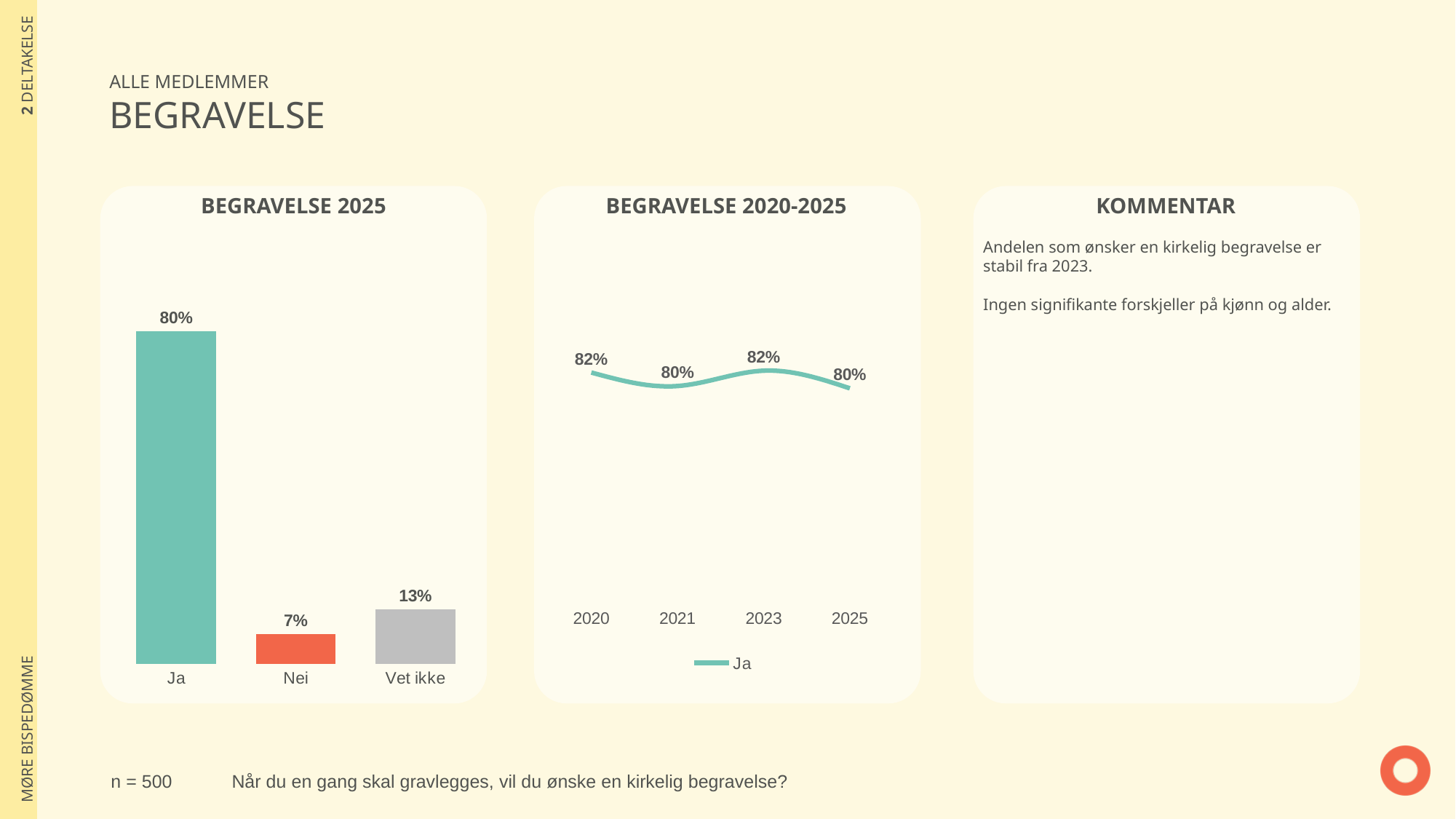
In the BEGRAVELSE 2020-2025 chart, how many data points are plotted? 4 In the BEGRAVELSE 2025 chart, how many categories are shown? 3 In the BEGRAVELSE 2025 chart, what is the difference between Ja and Vet ikke? 67% In the BEGRAVELSE 2025 chart, which category has the highest value? Ja In the BEGRAVELSE 2025 chart, what is the value for Nei? 7% In the BEGRAVELSE 2025 chart, what is the value for Ja? 80% In the BEGRAVELSE 2020-2025 chart, what is the value for 2021? 80% In the BEGRAVELSE 2025 chart, which category has the lowest value? Nei In the BEGRAVELSE 2025 chart, what is the value for Vet ikke? 13% What kind of chart is BEGRAVELSE 2025? Bar chart In the BEGRAVELSE 2020-2025 chart, what series does the legend list? Ja In the BEGRAVELSE 2020-2025 chart, what is the value for 2023? 82%